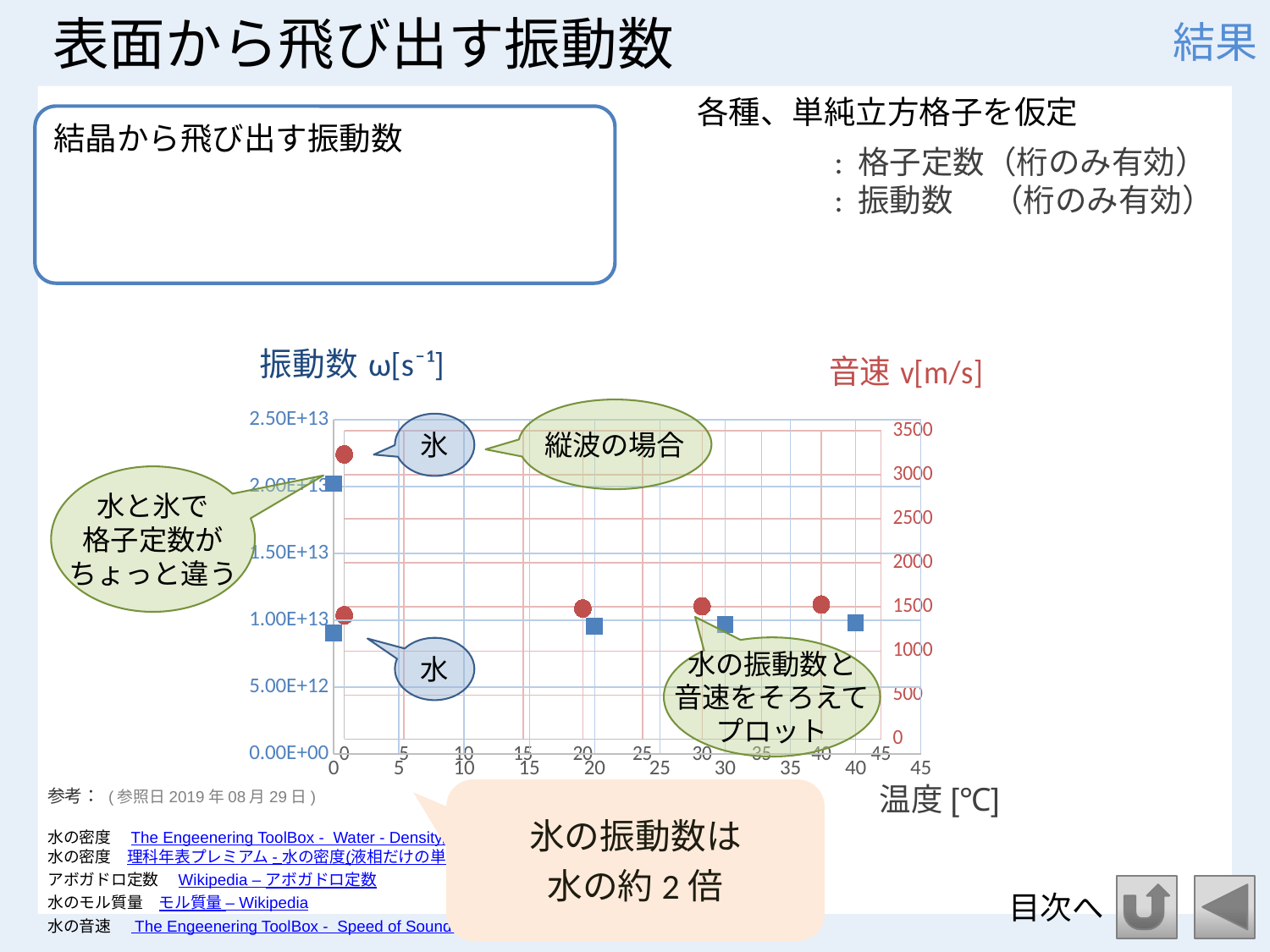
Which has the larger 音速, 氷 (ice) at 0℃ or water at 40℃? 氷 What is the title of the left vertical axis of the chart? 振動数 ω[s⁻¹] How many blue square points (振動数) are plotted on the chart? 5 Is the 振動数 value for 氷 (ice, at 0℃) greater or less than 1.50E+13? greater What kind of chart is shown on the slide? scatter chart Which has the larger 振動数 at 0℃, 氷 (ice) or 水 (water)? 氷 Is the 音速 value for 氷 (ice, at 0℃) greater or less than 3000? greater What is the title of the right vertical axis of the chart? 音速 v[m/s] Is the 振動数 value for water at 20℃ greater or less than 1.50E+13? less At which temperature is the highest 振動数 point plotted? 0℃ How many red circle points (音速) are plotted on the chart? 5